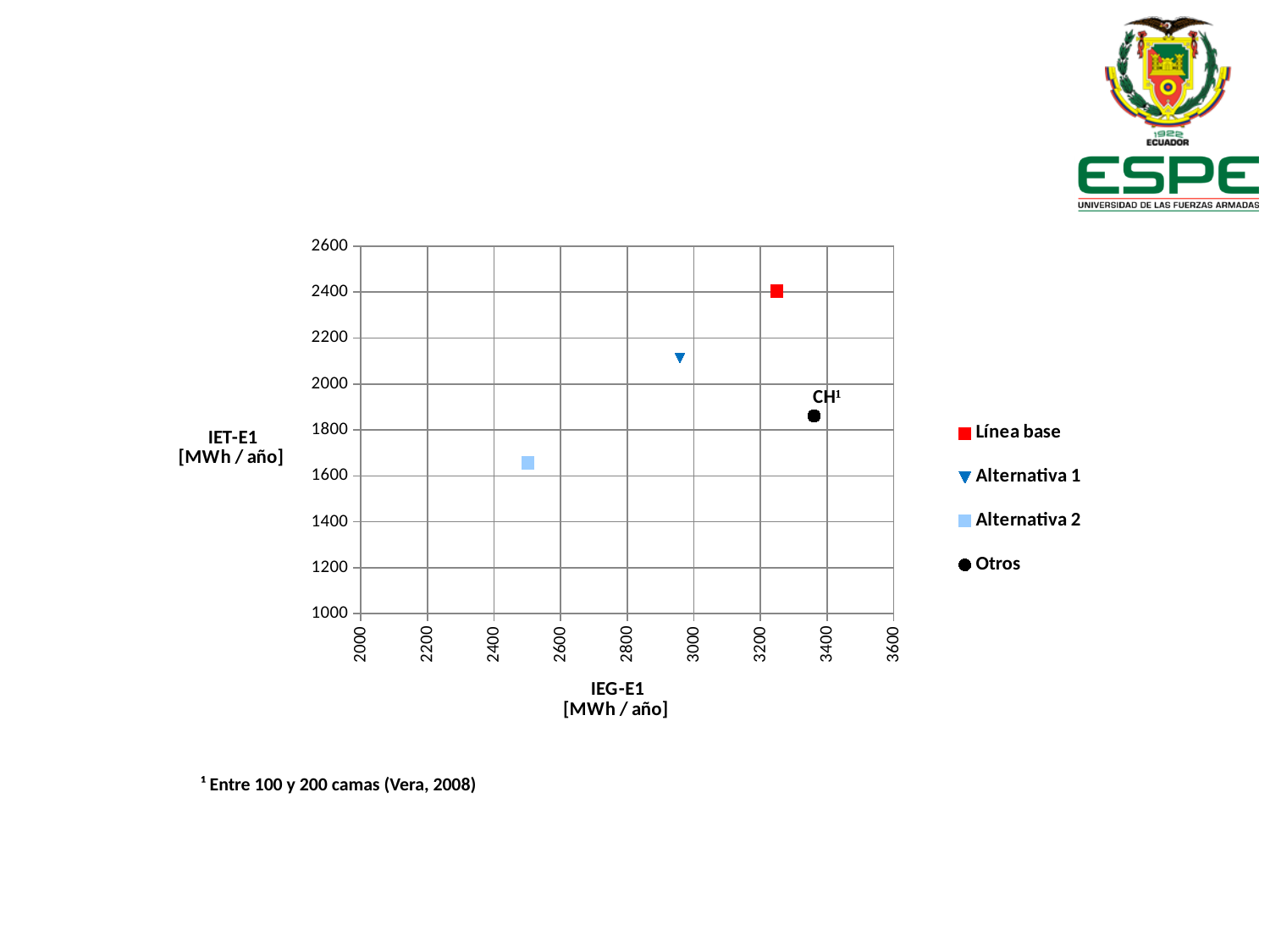
What label is printed next to the black circle point on the chart? CH¹ How many data points are plotted on the chart? 4 Which series has the highest IET-E1 value? Línea base What kind of chart is shown on the slide? scatter chart Which series has the lowest IET-E1 value? Alternativa 2 Which series has the lowest IEG-E1 value? Alternativa 2 Is the IET-E1 value for Otros greater or less than 2000? less Is the IET-E1 value for Alternativa 1 greater or less than 2000? greater How many series does the legend list? 4 Which series has the highest IEG-E1 value? Otros Which has a higher IET-E1 value, Alternativa 1 or Otros? Alternativa 1 Is the IEG-E1 value for Alternativa 2 greater or less than 2800? less